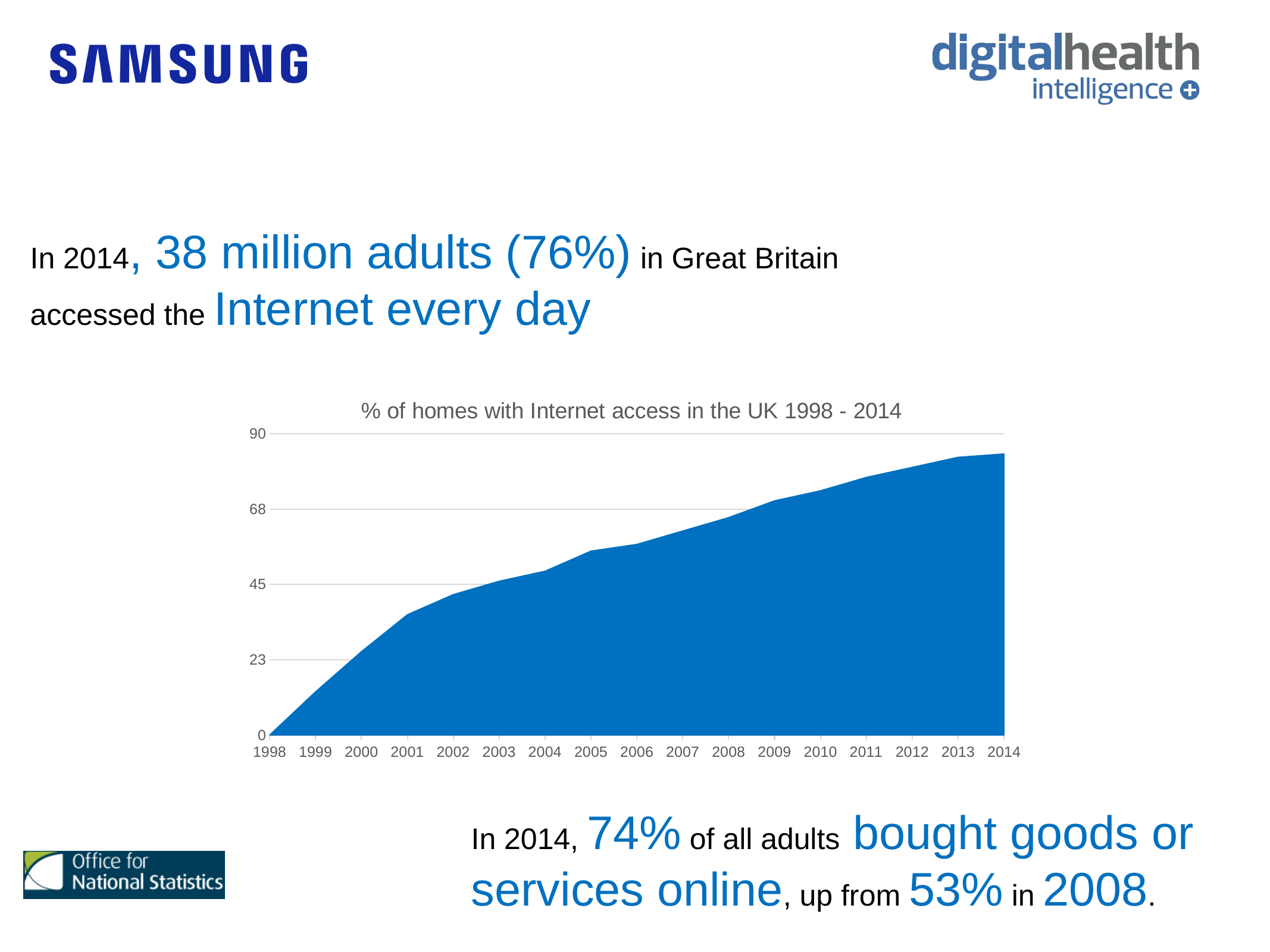
What is the title of the chart? % of homes with Internet access in the UK 1998 - 2014 Which year has the larger value, 2002 or 2010? 2010 Is the value for 2012 greater or less than 68? greater Which year has the highest value in the chart? 2014 Do the values in the chart rise or fall from 1998 to 2014? rise Which year has the lowest value in the chart? 1998 Is the value for 2014 greater or less than 68? greater What kind of chart is shown on the slide? area chart Is the value for 2006 greater or less than 45? greater How many years are plotted along the x axis of the chart? 17